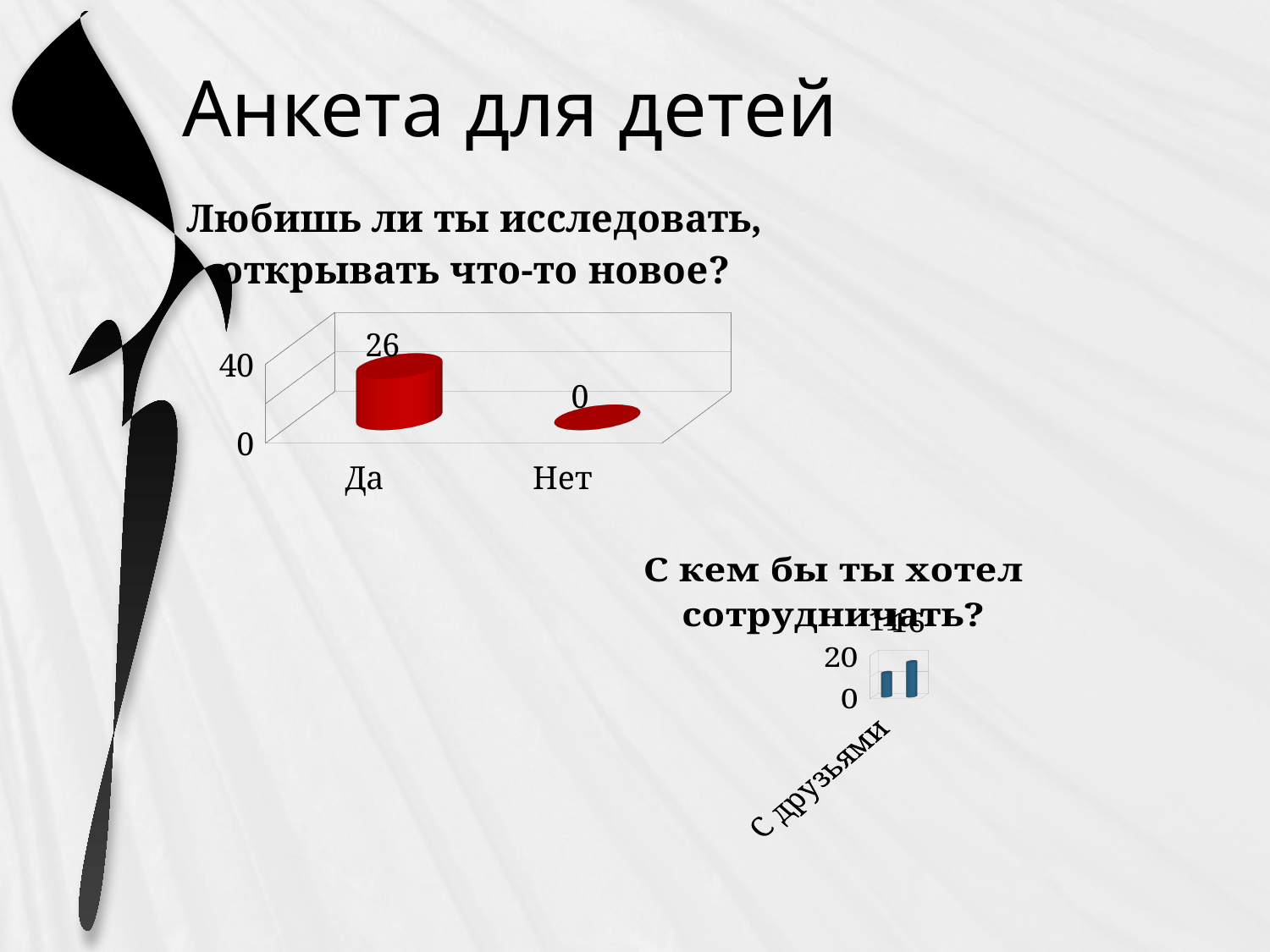
In the chart 'Любишь ли ты исследовать, открывать что-то новое?', what is the highest value shown on the vertical axis? 40 How many bars are shown in the chart 'С кем бы ты хотел сотрудничать?'? 2 What colour are the bars in the chart 'Любишь ли ты исследовать, открывать что-то новое?'? red In the chart 'Любишь ли ты исследовать, открывать что-то новое?', is the value for 'Да' greater or less than 40? less In the chart 'Любишь ли ты исследовать, открывать что-то новое?', what is the value for 'Да'? 26 What kind of chart is 'Любишь ли ты исследовать, открывать что-то новое?'? bar chart In the chart 'Любишь ли ты исследовать, открывать что-то новое?', which category has the highest value? Да In the chart 'Любишь ли ты исследовать, открывать что-то новое?', which category has the lowest value? Нет In the chart 'Любишь ли ты исследовать, открывать что-то новое?', what is the value for 'Нет'? 0 In the chart 'Любишь ли ты исследовать, открывать что-то новое?', which is larger, the value for 'Да' or for 'Нет'? Да In the chart 'Любишь ли ты исследовать, открывать что-то новое?', what is the difference between the values for 'Да' and 'Нет'? 26 How many categories are shown in the chart 'Любишь ли ты исследовать, открывать что-то новое?'? 2